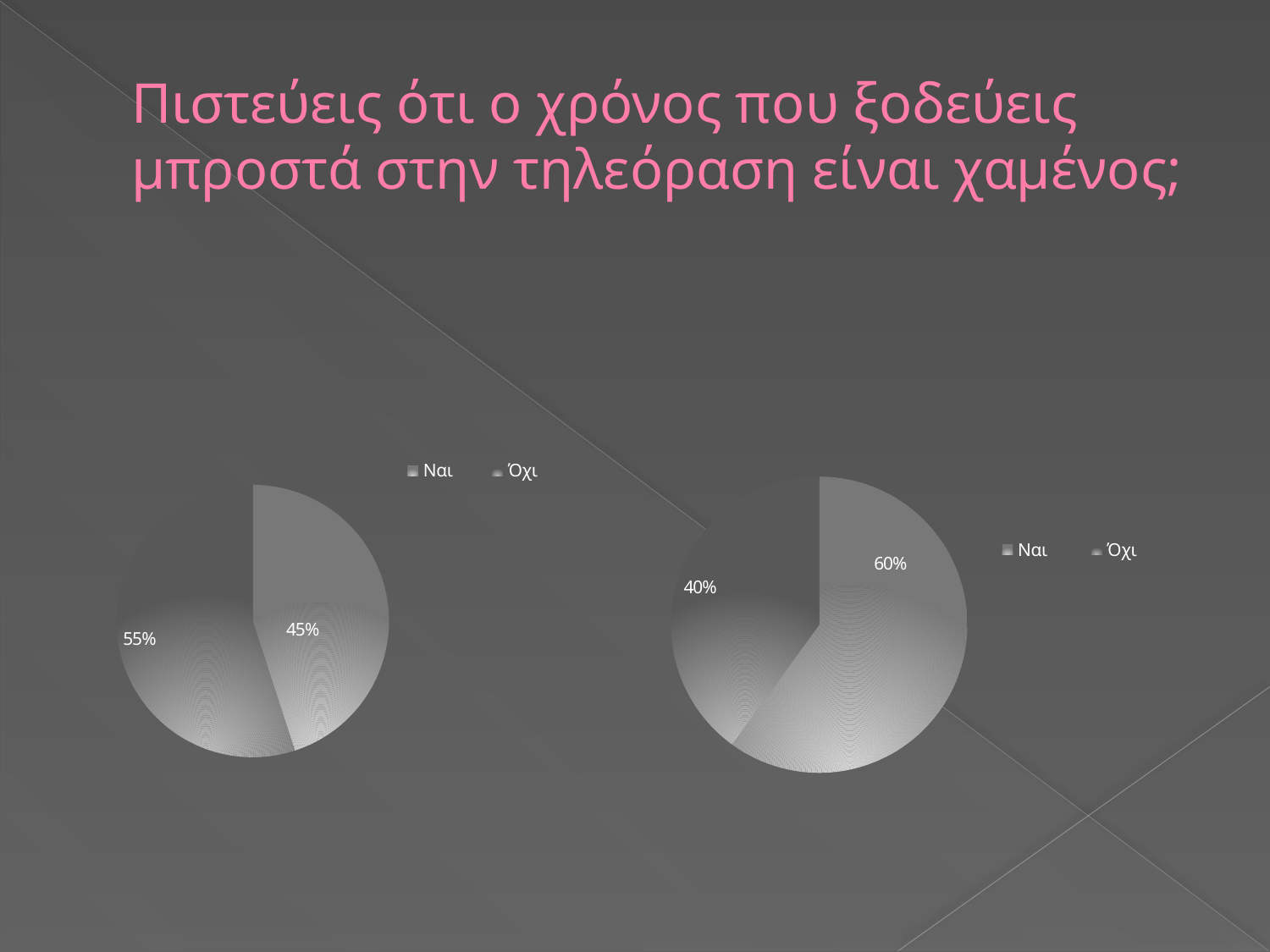
How many pie charts are shown on the slide? 2 In the right pie chart, which category has the smaller slice? Όχι In the left pie chart, which category has the larger slice? Όχι In the right pie chart, what is the difference between the Ναι and Όχι shares? 20% In the left pie chart, what is the difference between the Όχι and Ναι shares? 10% What kind of chart is the left chart on the slide? Pie chart In the right pie chart, what share is labelled for Ναι? 60% In the right pie chart, what share is labelled for Όχι? 40% In the right pie chart, which category has the larger slice? Ναι In the left pie chart, what share is labelled for Όχι? 55% In the left pie chart, what share is labelled for Ναι? 45% How many categories does the legend of the right pie chart list? 2